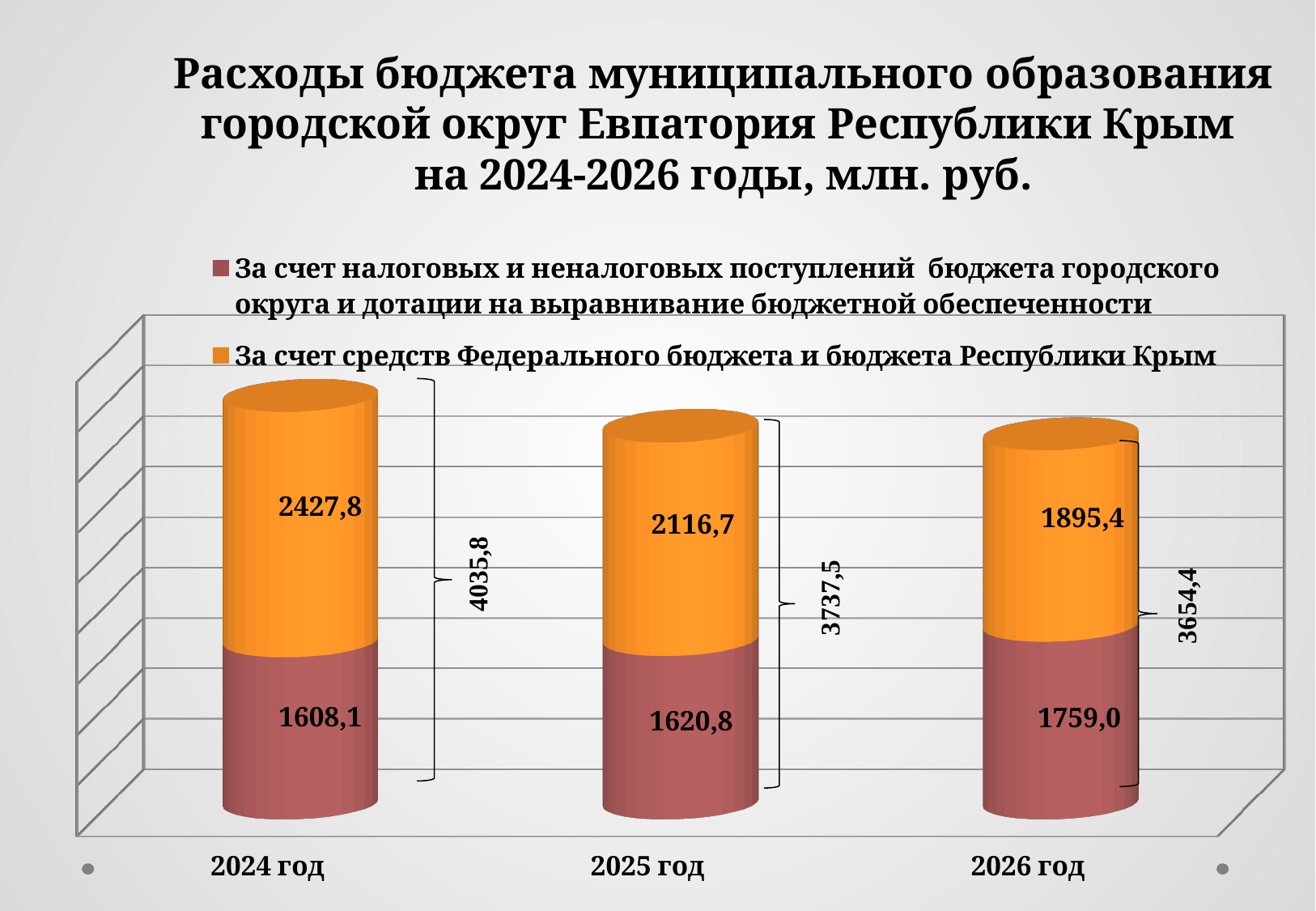
Which year has the highest total expenditure? 2024 год Which is larger in 2026 год: the value from federal and Republic of Crimea budget funds or the value from tax and non-tax revenues? За счет средств Федерального бюджета и бюджета Республики Крым How many series does the legend list? 2 What is the difference between the total for 2024 год and the total for 2026 год? 381,4 How many years (categories) are shown on the x axis? 3 Which year has the lowest value for the series 'За счет средств Федерального бюджета и бюджета Республики Крым'? 2026 год What is the value for 2026 год in the series 'За счет налоговых и неналоговых поступлений бюджета городского округа и дотации на выравнивание бюджетной обеспеченности'? 1759,0 What is the difference between the 2024 год and 2025 год values for the series 'За счет средств Федерального бюджета и бюджета Республики Крым'? 311,1 What is the value for 2024 год in the series 'За счет средств Федерального бюджета и бюджета Республики Крым'? 2427,8 Do the values for the series 'За счет налоговых и неналоговых поступлений бюджета городского округа и дотации на выравнивание бюджетной обеспеченности' rise or fall from 2024 год to 2026 год? Rise What kind of chart is shown on the slide? Stacked bar chart What is the total of the stacked bar for 2025 год? 3737,5